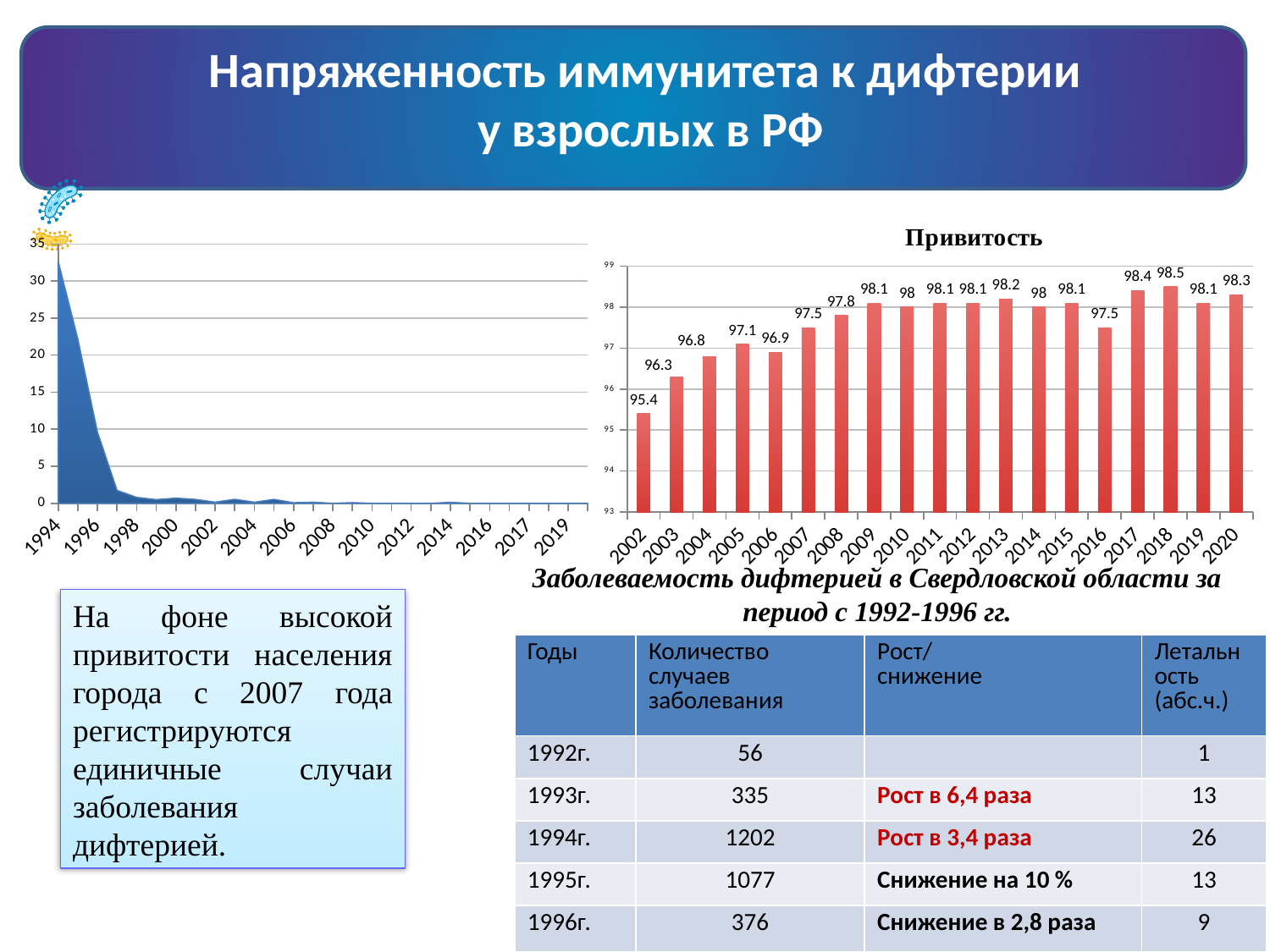
In the chart titled "Привитость", what is the value for 2002? 95.4 In the chart titled "Привитость", what is the difference between the values for 2018 and 2002? 3.1 In the chart on the left of the slide (years 1994–2019), do the values rise or fall from 1994 to 1998? fall In the chart titled "Привитость", which is larger, the value for 2005 or the value for 2006? 2005 In the chart titled "Привитость", what kind of chart is it? bar chart In the chart titled "Привитость", what is the value for 2016? 97.5 In the chart titled "Привитость", how many years are plotted? 19 In the chart titled "Привитость", which year has the highest value? 2018 In the chart titled "Привитость", which year has the lowest value? 2002 In the chart on the left of the slide (years 1994–2019), what kind of chart is it? area chart In the chart on the left of the slide (years 1994–2019), is the value for 1994 greater or less than 30? greater In the chart titled "Привитость", what is the value for 2020? 98.3